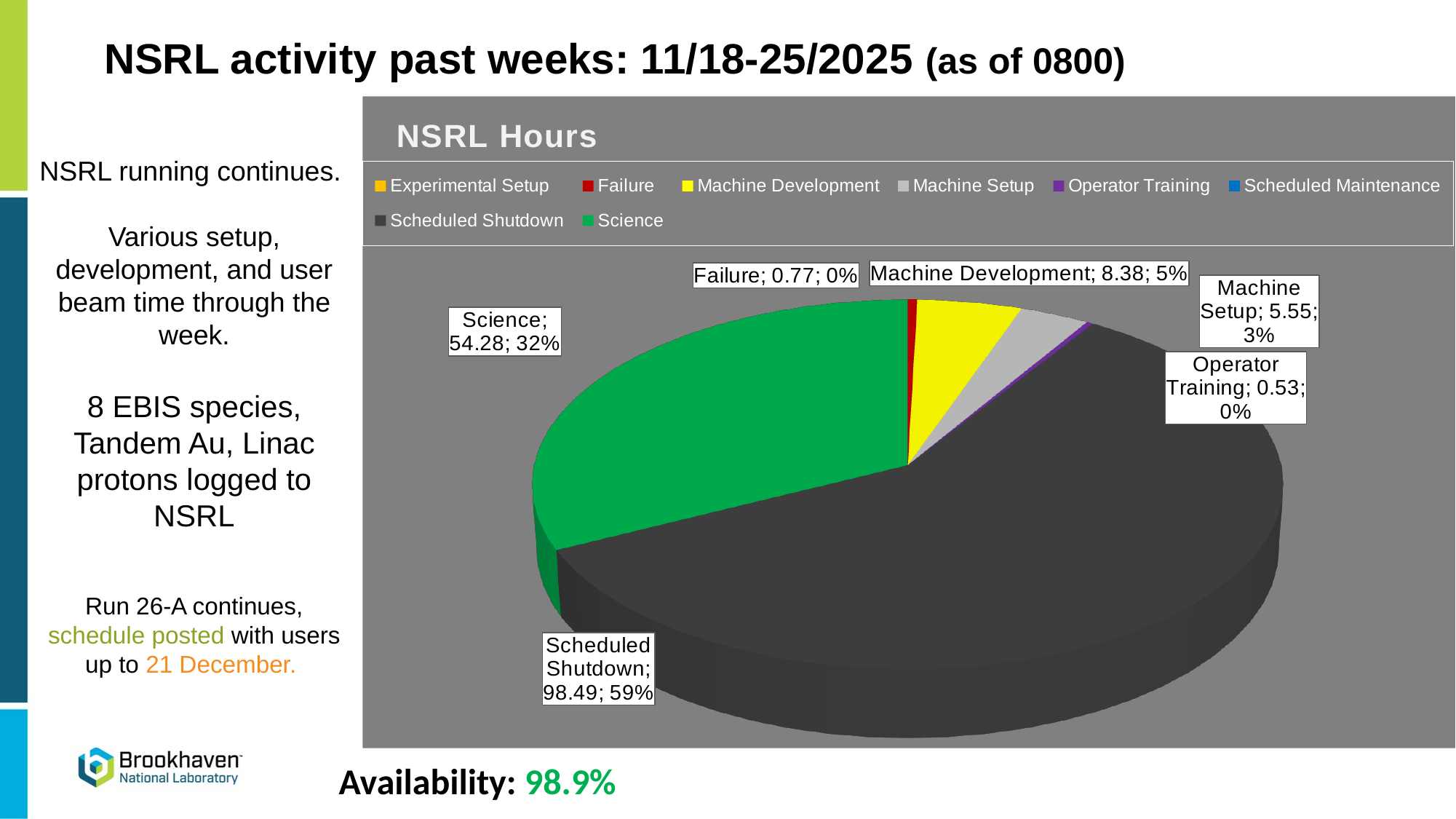
What percentage share of the pie does Scheduled Shutdown have? 59% How many entries does the chart legend list? 8 How many hours are labelled for Scheduled Shutdown? 98.49 What percentage share of the pie does Science have? 32% What is the difference in hours between Scheduled Shutdown and Science? 44.21 What is the title of the chart? NSRL Hours How many hours are labelled for Machine Development? 8.38 How many hours are labelled for Science? 54.28 Which has more hours, Machine Development or Machine Setup? Machine Development How many hours are labelled for Machine Setup? 5.55 What kind of chart is shown on the slide? Pie chart Which category has the largest slice of the pie? Scheduled Shutdown